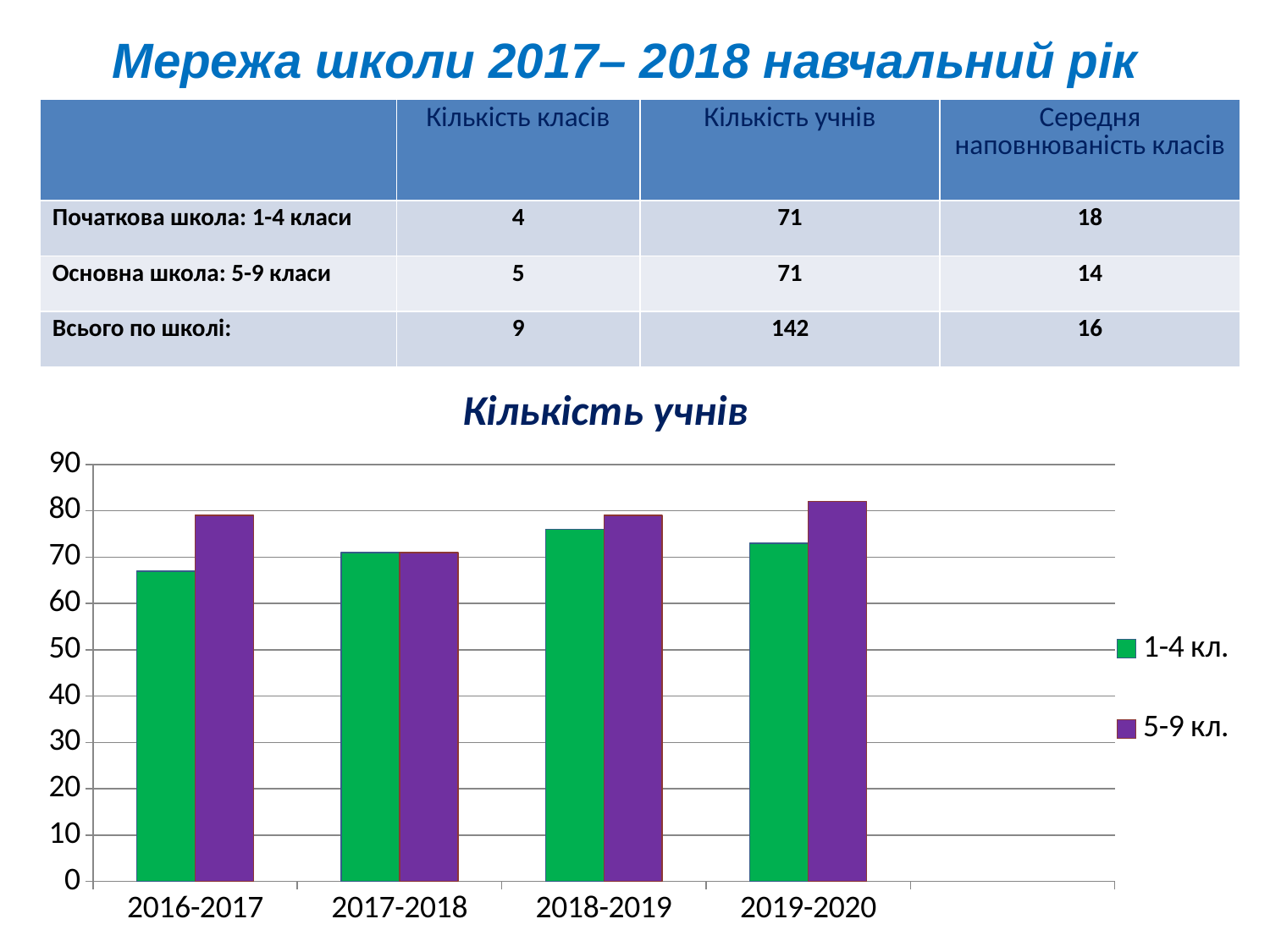
Is the value for 5-9 кл. in 2016-2017 greater or less than 70? greater In which school year is the 1-4 кл. value lowest? 2016-2017 What kind of chart is shown on the slide? bar chart In 2016-2017, which series has the larger value, 1-4 кл. or 5-9 кл.? 5-9 кл. In which school year is the 5-9 кл. value highest? 2019-2020 Is the value for 1-4 кл. in 2016-2017 greater or less than 70? less How many series does the chart legend list? 2 Is the value for 1-4 кл. in 2018-2019 greater or less than 70? greater Which colour represents the 5-9 кл. series in the chart? purple How many school-year categories are shown on the x axis of the chart? 4 Does the 1-4 кл. value rise or fall from 2016-2017 to 2017-2018? rise What is the title of the chart? Кількість учнів